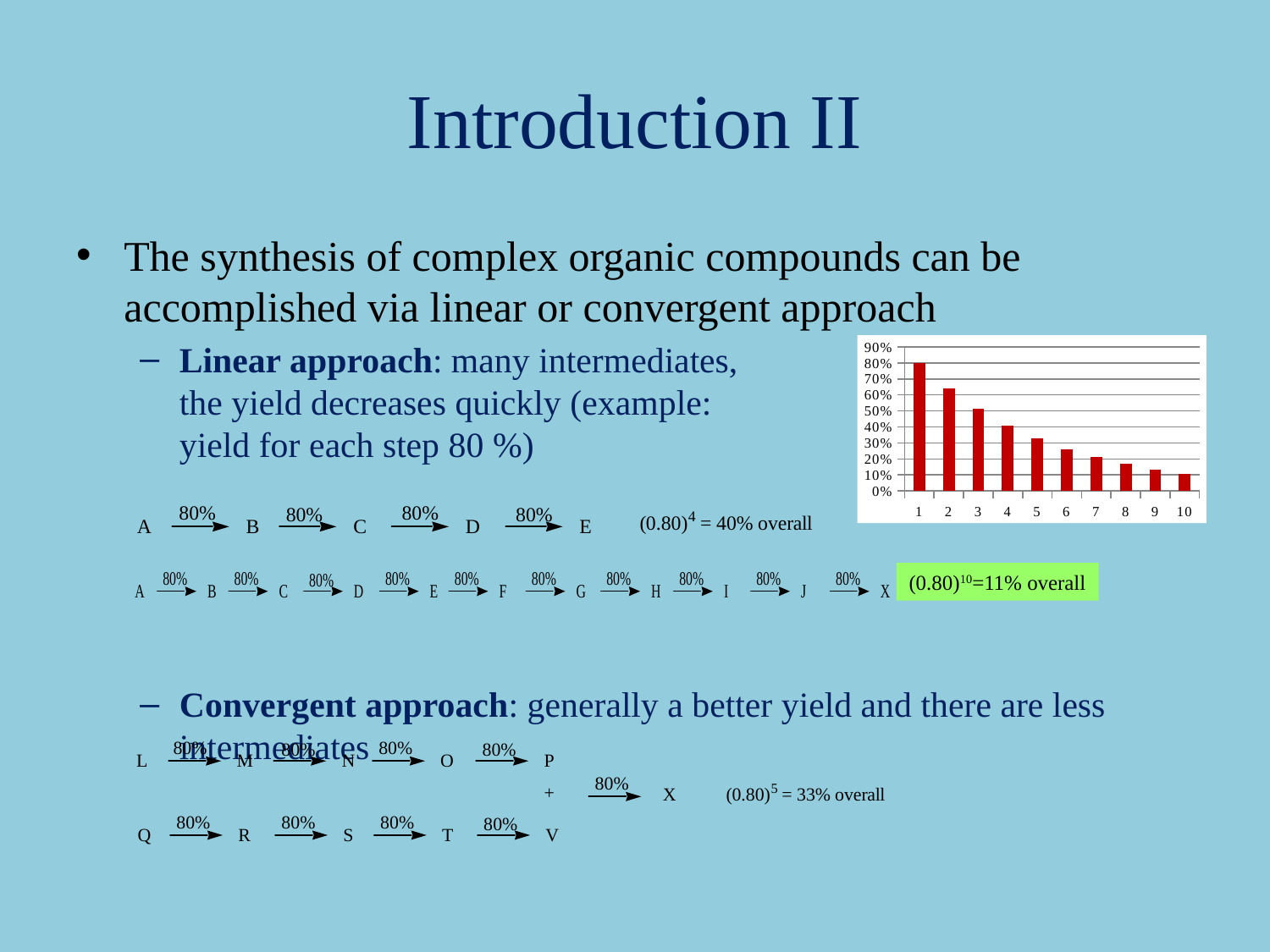
Is the value for category 2 greater or less than 60%? greater How many categories are shown on the x axis of the chart? 10 Which category has the lowest bar in the chart? 10 Which is larger, the value for category 2 or the value for category 5? category 2 Which category has the highest bar in the chart? 1 What is the value for category 1 in the chart? 80% Is the value for category 6 greater or less than 30%? less What is the highest value shown on the y axis of the chart? 90% What colour are the bars in the chart? red What kind of chart is shown on the slide? bar chart Is the value for category 8 greater or less than 20%? less Do the bar values rise or fall from category 1 to category 10? fall